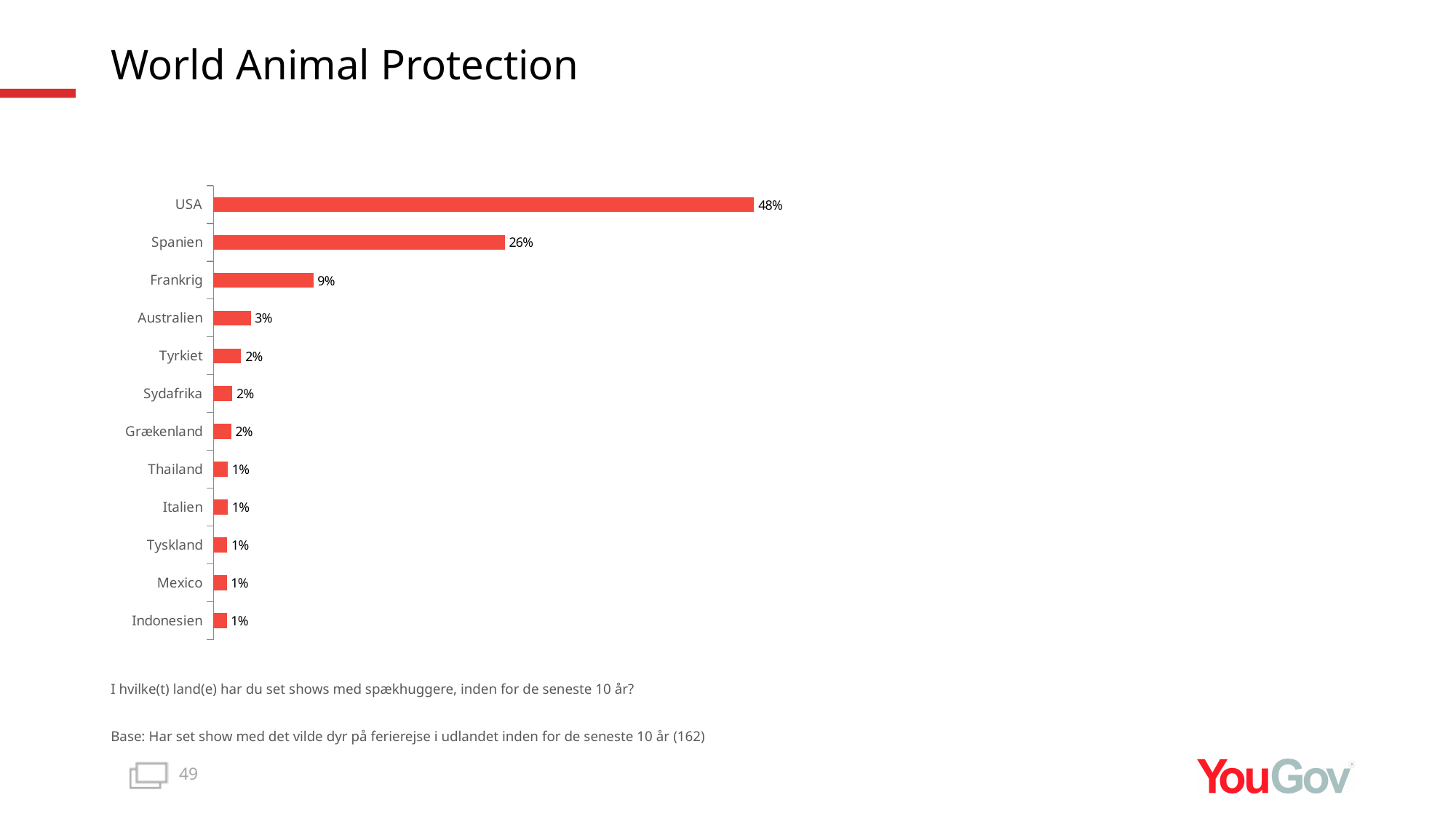
What colour are the bars in the chart? Red What is the value for Australien? 3% Which is larger, the value for Frankrig or the value for Australien? Frankrig How many countries have a value of 1%? 5 What is the difference between the values for Spanien and Frankrig? 17% What is the value for USA? 48% What is the difference between the values for USA and Spanien? 22% Which country has the highest value? USA How many countries are shown in the chart? 12 What is the value for Frankrig? 9% What is the value for Spanien? 26% What kind of chart is shown on the slide? Bar chart